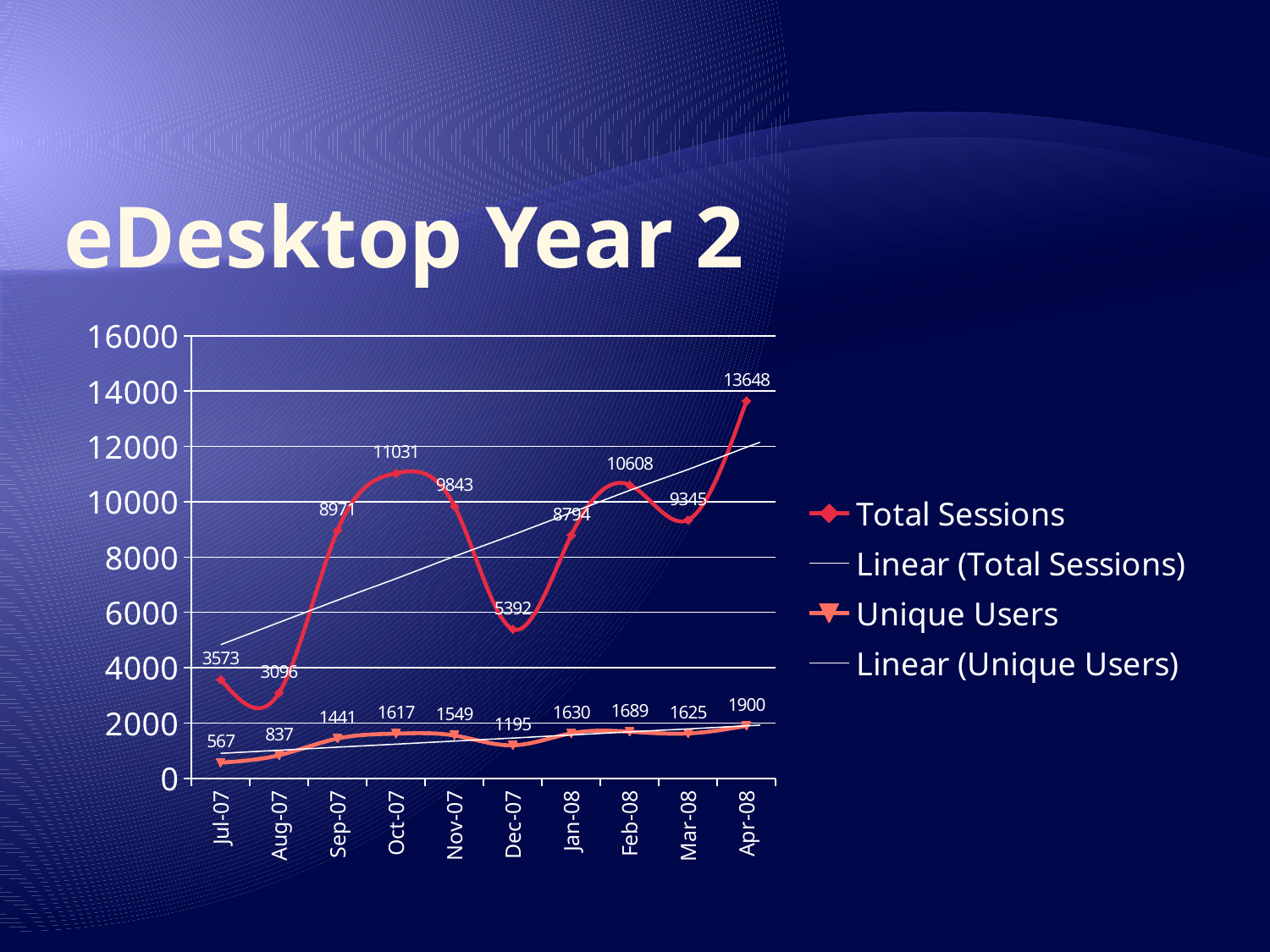
In which month is Total Sessions highest? Apr-08 What is the Total Sessions value for Dec-07? 5392 What kind of chart is shown on the slide? Line chart What is the Total Sessions value for Oct-07? 11031 By how much did Total Sessions increase from Mar-08 to Apr-08? 4303 In which month is Unique Users lowest? Jul-07 Which month has more Total Sessions, Nov-07 or Feb-08? Feb-08 What is the difference in Unique Users between Feb-08 and Jan-08? 59 In which month is Total Sessions lowest? Aug-07 How many entries does the legend list? 4 How many months are plotted on the x axis? 10 What is the Unique Users value for Apr-08? 1900